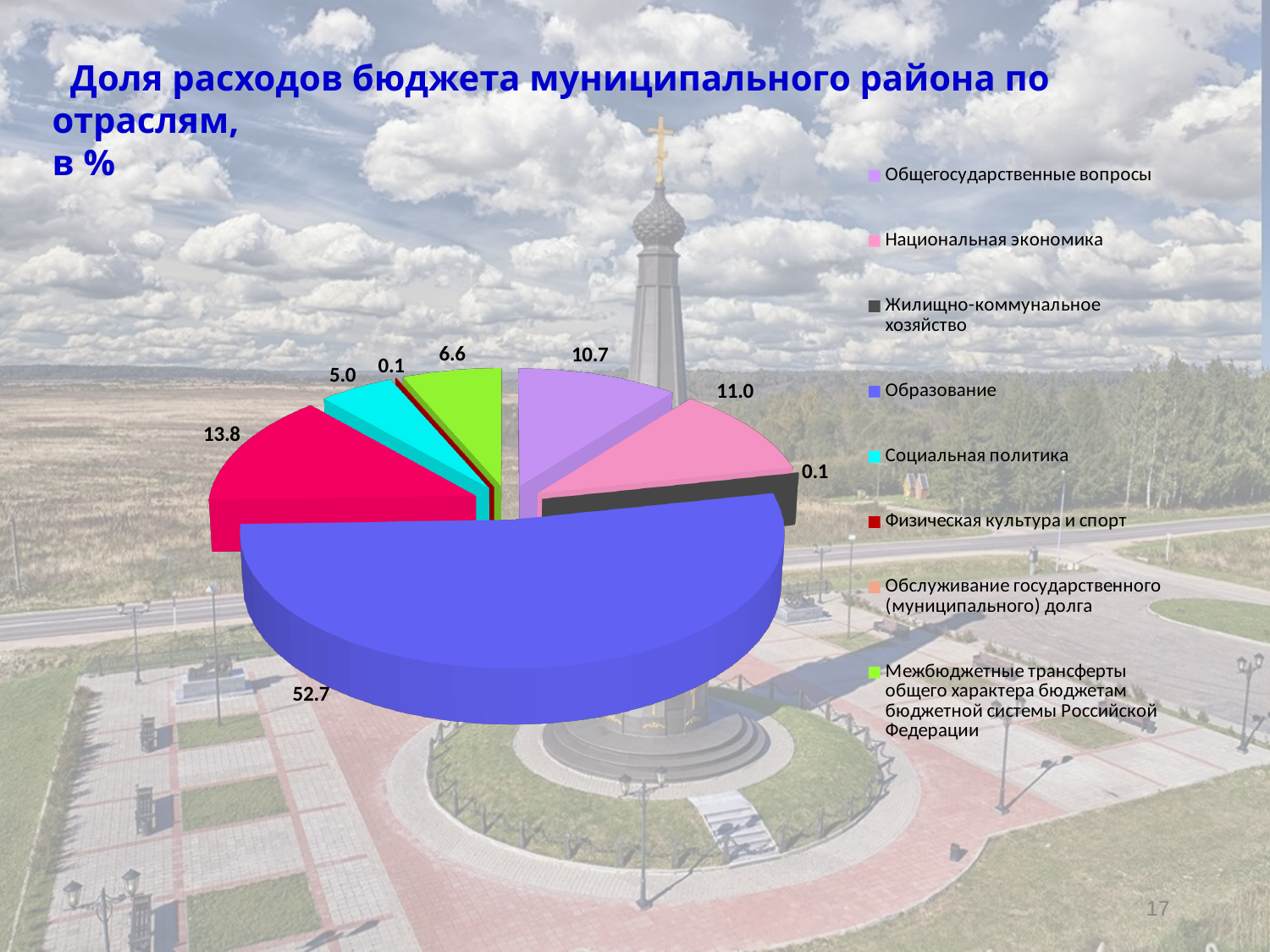
What is the difference between the largest slice (52.7) and the second largest slice (13.8)? 38.9 Which category has the largest share of the pie? Образование What is the share for Межбюджетные трансферты общего характера бюджетам бюджетной системы Российской Федерации? 6.6 How many slices does the pie chart have? 8 What is the share for Общегосударственные вопросы? 10.7 What is the share for Жилищно-коммунальное хозяйство? 0.1 What is the share for Образование? 52.7 How many entries does the legend list? 8 What is the difference between the shares for Национальная экономика and Общегосударственные вопросы? 0.3 What is the share for Национальная экономика? 11.0 What type of chart is shown on the slide? Pie chart Which is larger, the share for Национальная экономика or for Общегосударственные вопросы? Национальная экономика